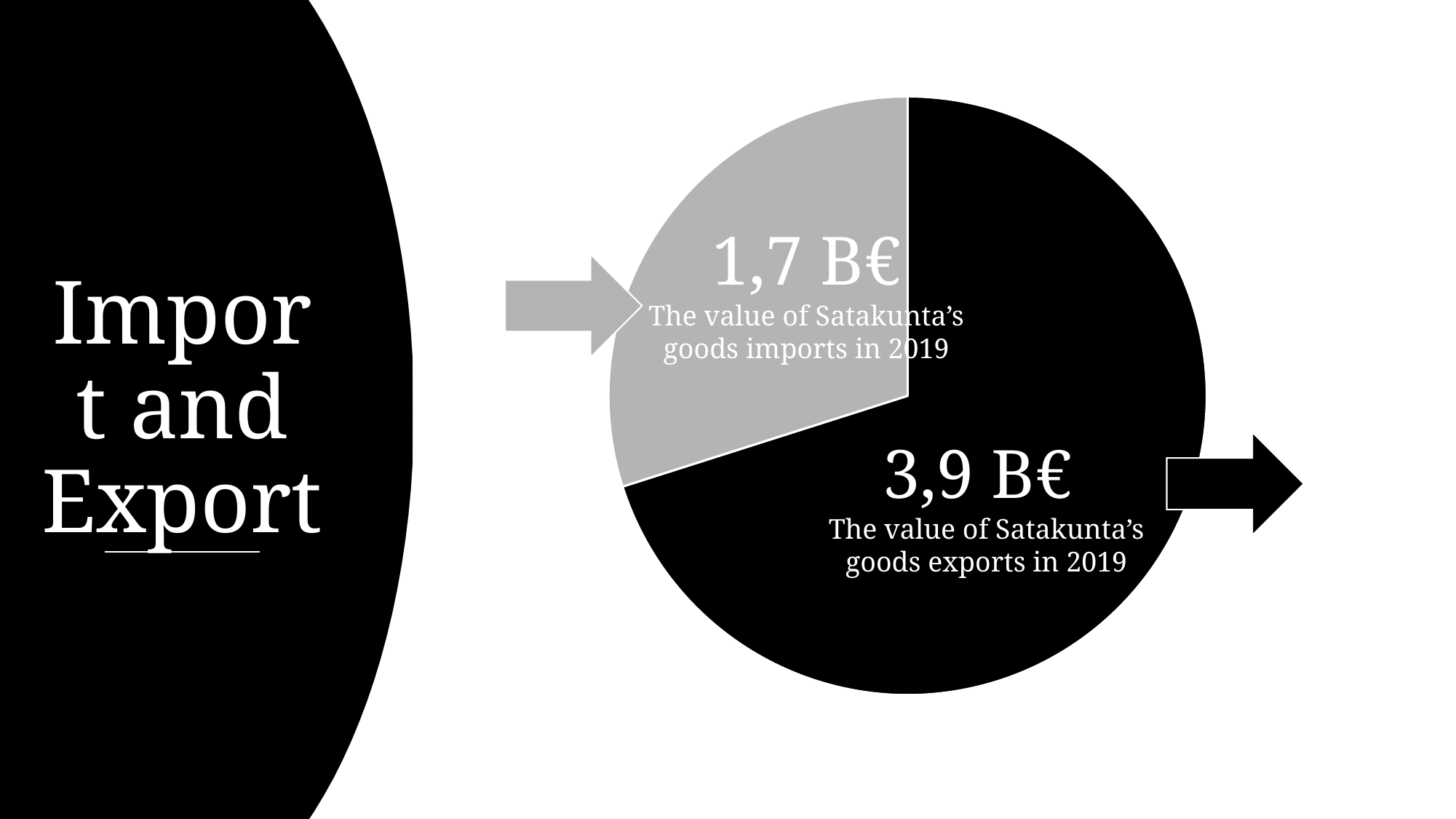
Which slice of the pie chart is the largest? Goods exports (3,9 B€) What is the difference between the value of goods exports and goods imports? 2,2 B€ What is the value of Satakunta's goods imports in 2019 shown on the pie chart? 1,7 B€ Which is larger, the value of goods imports or the value of goods exports? Goods exports Which slice of the pie chart is the smallest? Goods imports (1,7 B€) What is the combined value of goods imports and goods exports shown on the pie chart? 5,6 B€ What is the title of the slide? Import and Export What colour is the slice representing goods imports? Grey How many slices does the pie chart have? 2 What kind of chart is shown on the slide? Pie chart What is the value of Satakunta's goods exports in 2019 shown on the pie chart? 3,9 B€